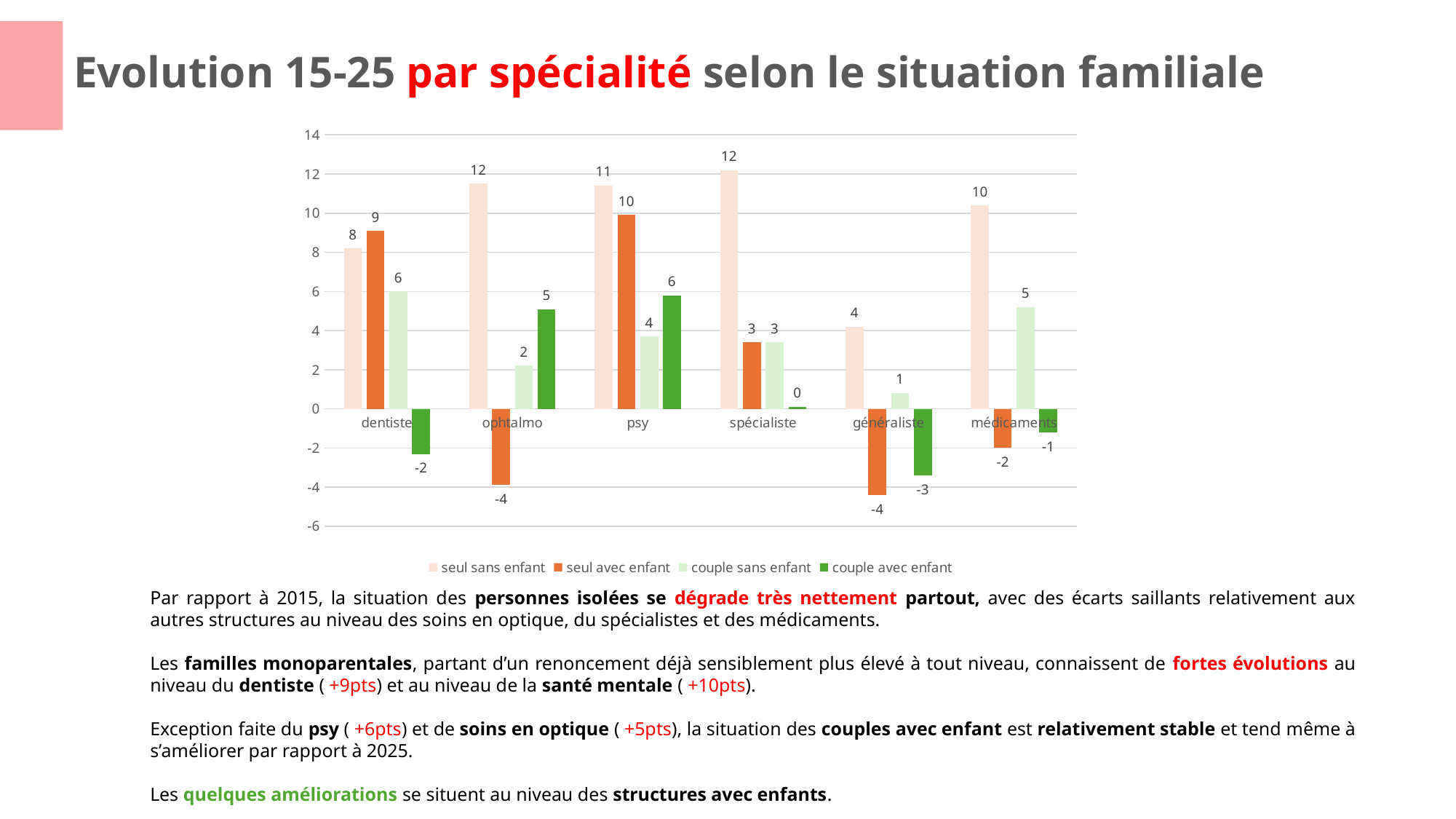
What is the value for 'couple avec enfant' in the ophtalmo category? 5 What is the value for 'couple sans enfant' in the médicaments category? 5 How many categories are shown on the x axis of the chart? 6 What colour are the bars for the 'seul avec enfant' series? orange What is the value for 'seul avec enfant' in the généraliste category? -4 Which category has the lowest value for the 'couple avec enfant' series? généraliste How many series does the legend list? 4 Which category has the lowest value for the 'seul sans enfant' series? généraliste What is the value for 'seul avec enfant' in the psy category? 10 In the dentiste category, what is the difference between the 'seul avec enfant' value and the 'couple avec enfant' value? 11 What kind of chart is shown on the slide? bar chart In the médicaments category, which is larger: 'seul sans enfant' or 'couple sans enfant'? seul sans enfant